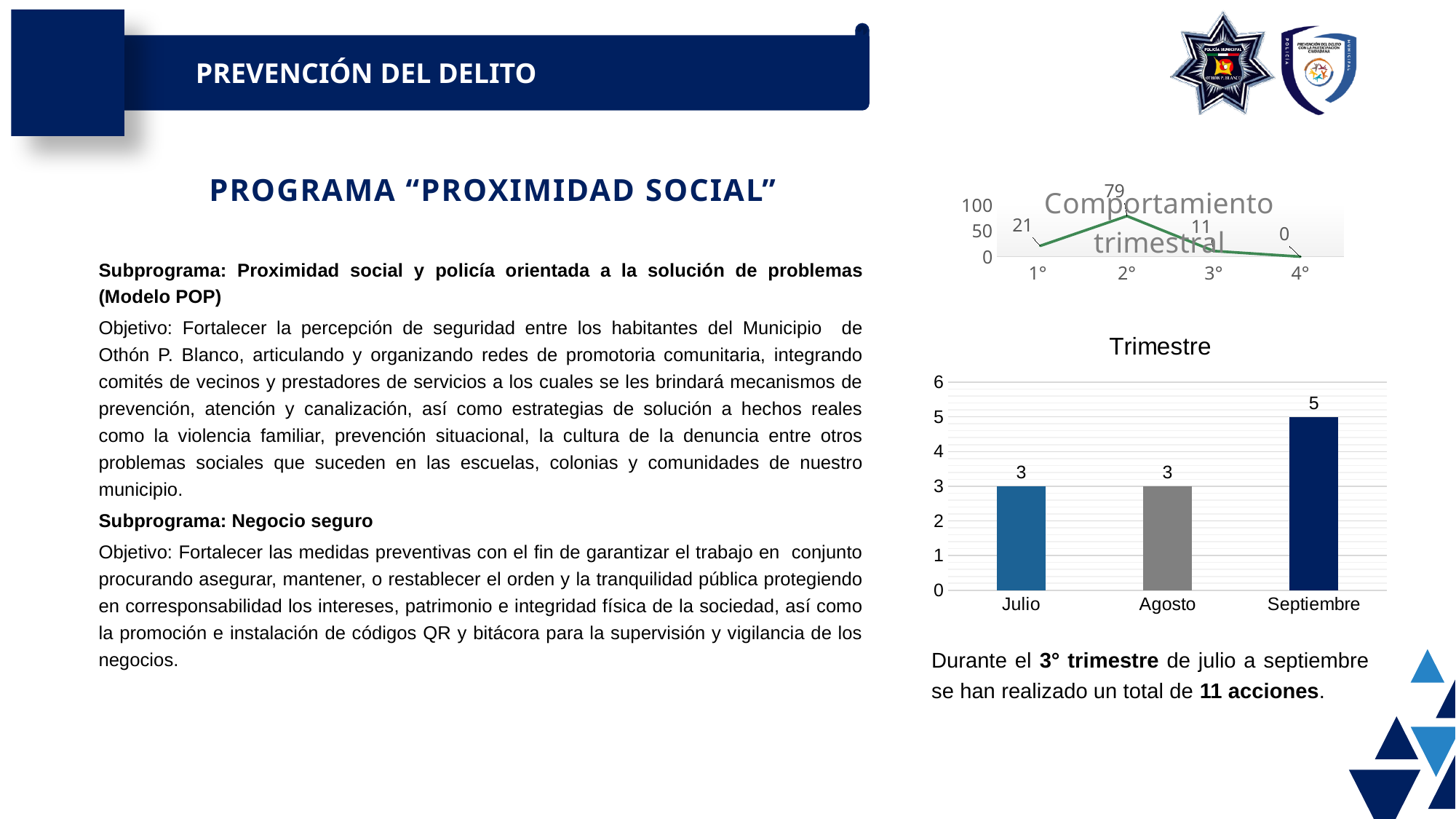
In the 'Trimestre' chart, what is the value for Julio? 3 In the 'Comportamiento trimestral' chart, what is the value for 2°? 79 In the 'Comportamiento trimestral' chart, what is the value for 4°? 0 In the 'Comportamiento trimestral' chart, what is the difference between the values for 1° and 3°? 10 What kind of chart is the 'Comportamiento trimestral' chart? line chart In the 'Trimestre' chart, which month has the highest value? Septiembre In the 'Trimestre' chart, how many bars are plotted? 3 In the 'Trimestre' chart, what is the value for Septiembre? 5 What kind of chart is the 'Trimestre' chart? bar chart In the 'Trimestre' chart, what is the difference between the values for Septiembre and Agosto? 2 In the 'Comportamiento trimestral' chart, which quarter has the highest value? 2° In the 'Trimestre' chart, what is the total of the three monthly values? 11